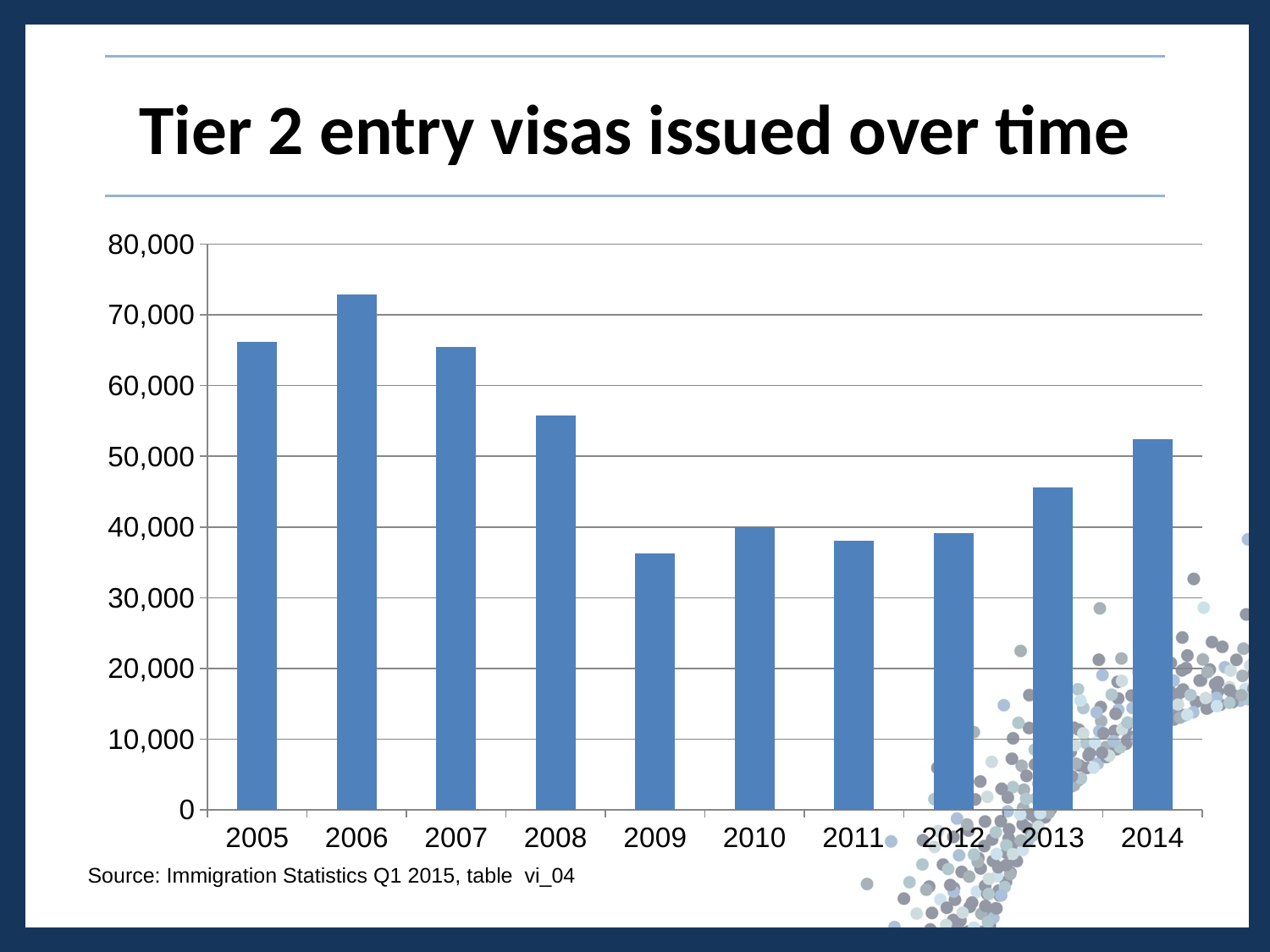
Which year has the highest number of Tier 2 entry visas issued? 2006 Is the value for 2009 greater or less than 40,000? less Which year has the larger value, 2008 or 2014? 2008 What is the title of the slide? Tier 2 entry visas issued over time Is the value for 2006 greater or less than 70,000? greater Is the value for 2014 greater or less than 50,000? greater Which year has the larger value, 2012 or 2013? 2013 Which year has the lowest number of Tier 2 entry visas issued? 2009 Do the values rise or fall from 2005 to 2009? fall How many years are shown on the x axis of the chart? 10 What kind of chart is shown on the slide? Bar chart